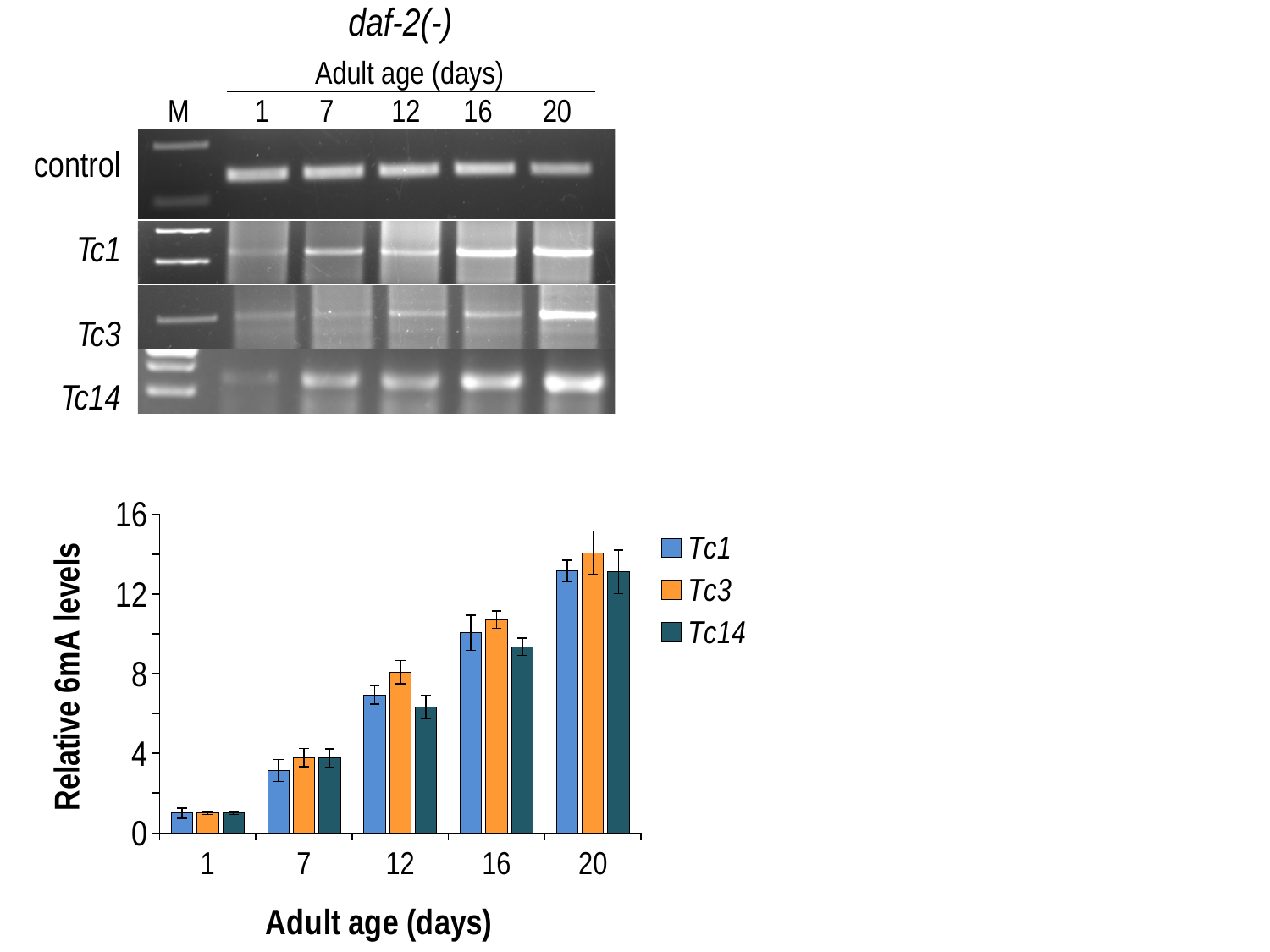
At adult age 12 days, which series has the larger value, Tc3 or Tc14? Tc3 Is the Tc14 value at adult age 16 days greater or less than 8? greater What is the label of the y axis of the bar chart? Relative 6mA levels At which adult age is the Tc3 relative 6mA level highest? 20 At which adult age is the Tc14 relative 6mA level lowest? 1 How many series does the legend of the bar chart list? 3 Is the Tc1 value at adult age 12 days greater or less than 8? less What kind of chart is shown at the bottom of the slide? bar chart Is the Tc3 value at adult age 20 days greater or less than 12? greater Do the relative 6mA levels for Tc1 rise or fall as adult age increases along the x axis? rise What colour represents Tc3 in the bar chart legend? orange How many adult age categories are shown on the x axis of the bar chart? 5